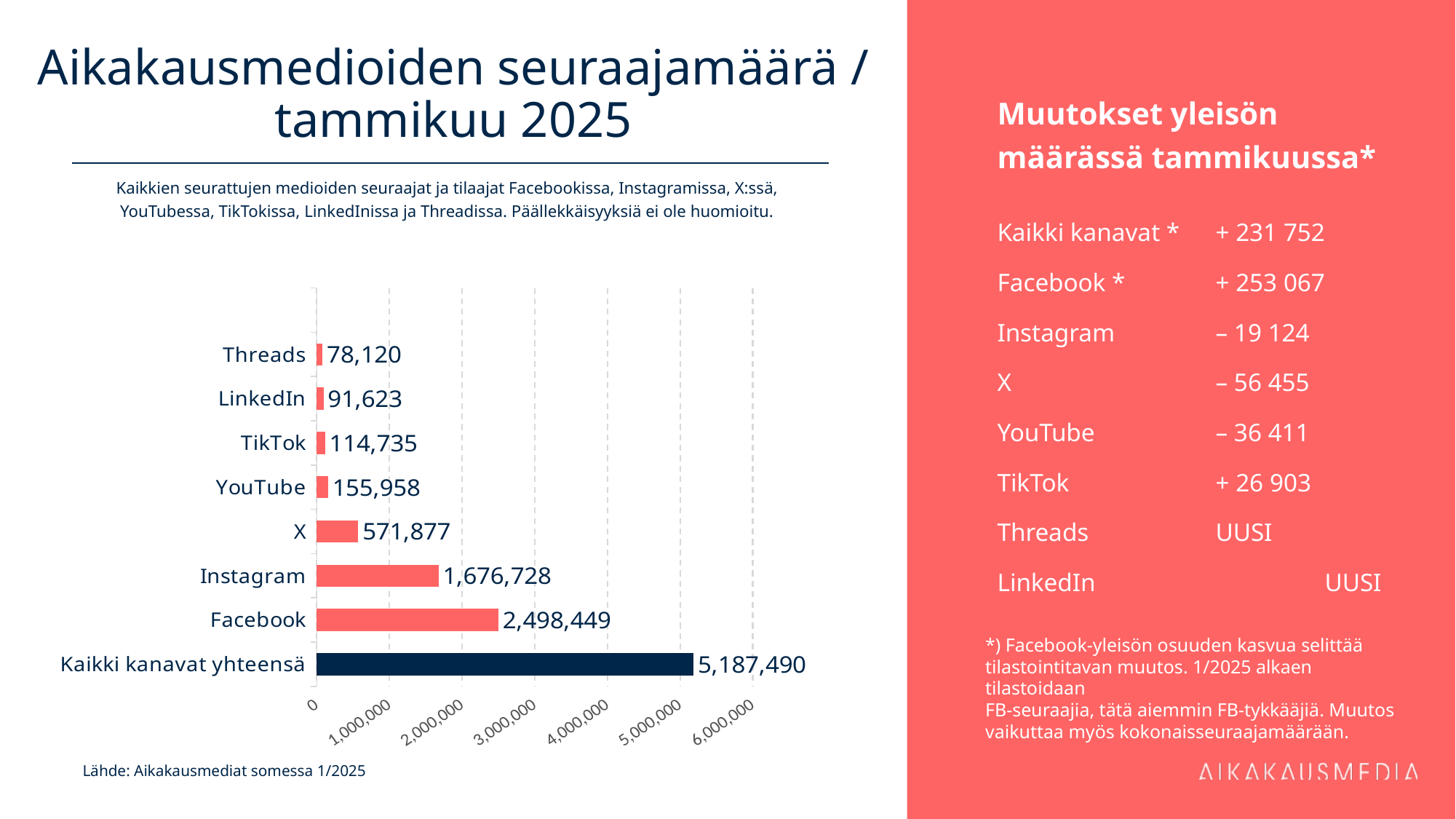
What is the value for TikTok? 114,735 Is the value for Instagram greater or less than 2,000,000? less Which is larger, the value for YouTube or the value for X? X How many categories are shown in the chart? 8 What is the value for X? 571,877 Which category has the lowest value? Threads What is the value for Facebook? 2,498,449 Which category has the highest value? Kaikki kanavat yhteensä What is the value for Kaikki kanavat yhteensä? 5,187,490 What is the difference between the values for Facebook and Instagram? 821,721 What is the difference between the values for LinkedIn and Threads? 13,503 What kind of chart is shown on the slide? bar chart